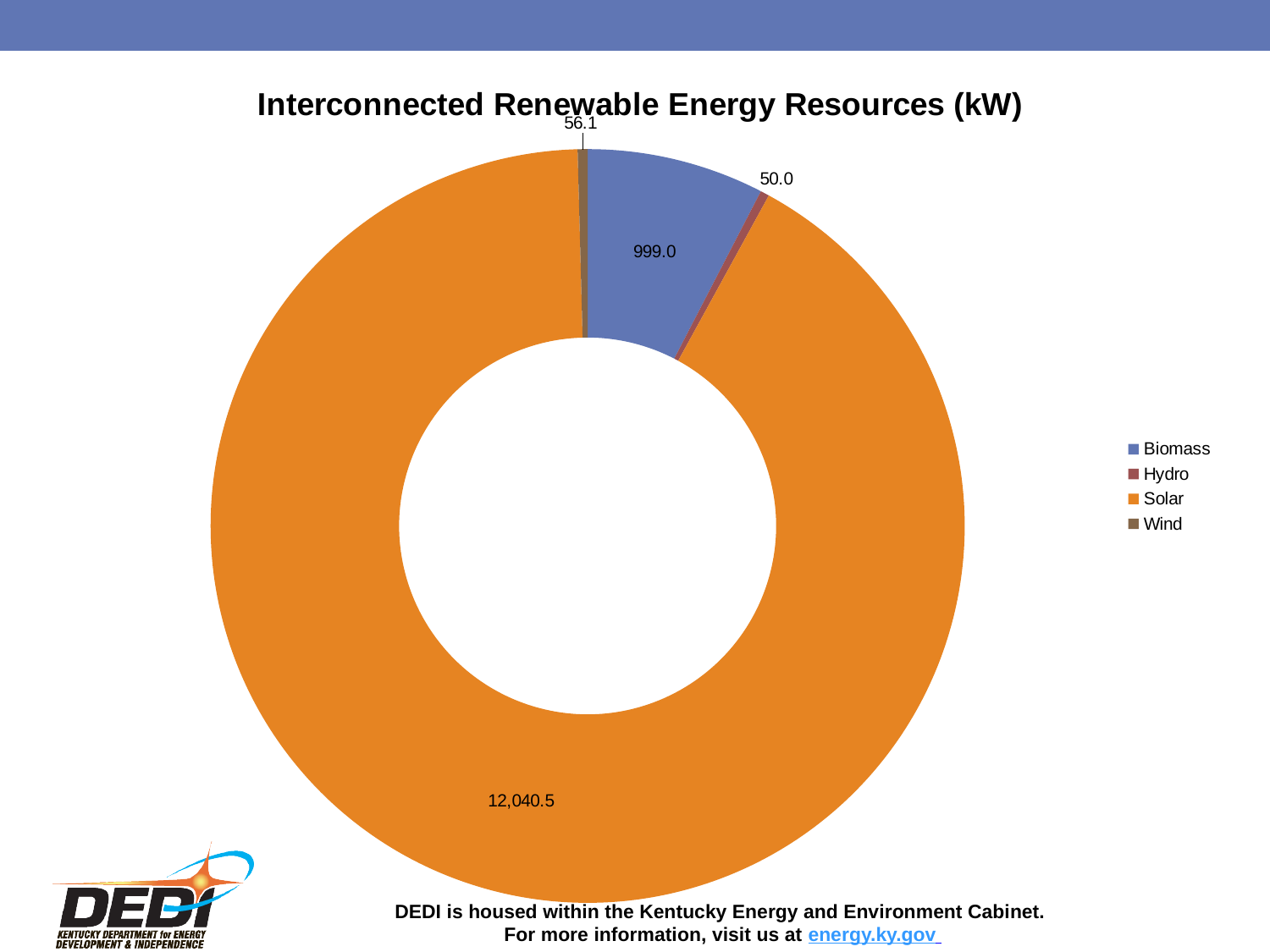
What is the difference between the Wind value and the Hydro value? 6.1 Which category has the largest value in the chart? Solar Which is larger, the value for Wind or the value for Hydro? Wind How many categories does the chart show? 4 What is the value for Solar in the Interconnected Renewable Energy Resources chart? 12,040.5 Which category has the smallest value in the chart? Hydro What is the value for Wind in the chart? 56.1 What kind of chart is shown on the slide? Doughnut chart What is the value for Hydro in the chart? 50.0 What is the value for Biomass in the chart? 999.0 What is the difference between the Solar value and the Biomass value? 11,041.5 What is the title of the chart? Interconnected Renewable Energy Resources (kW)